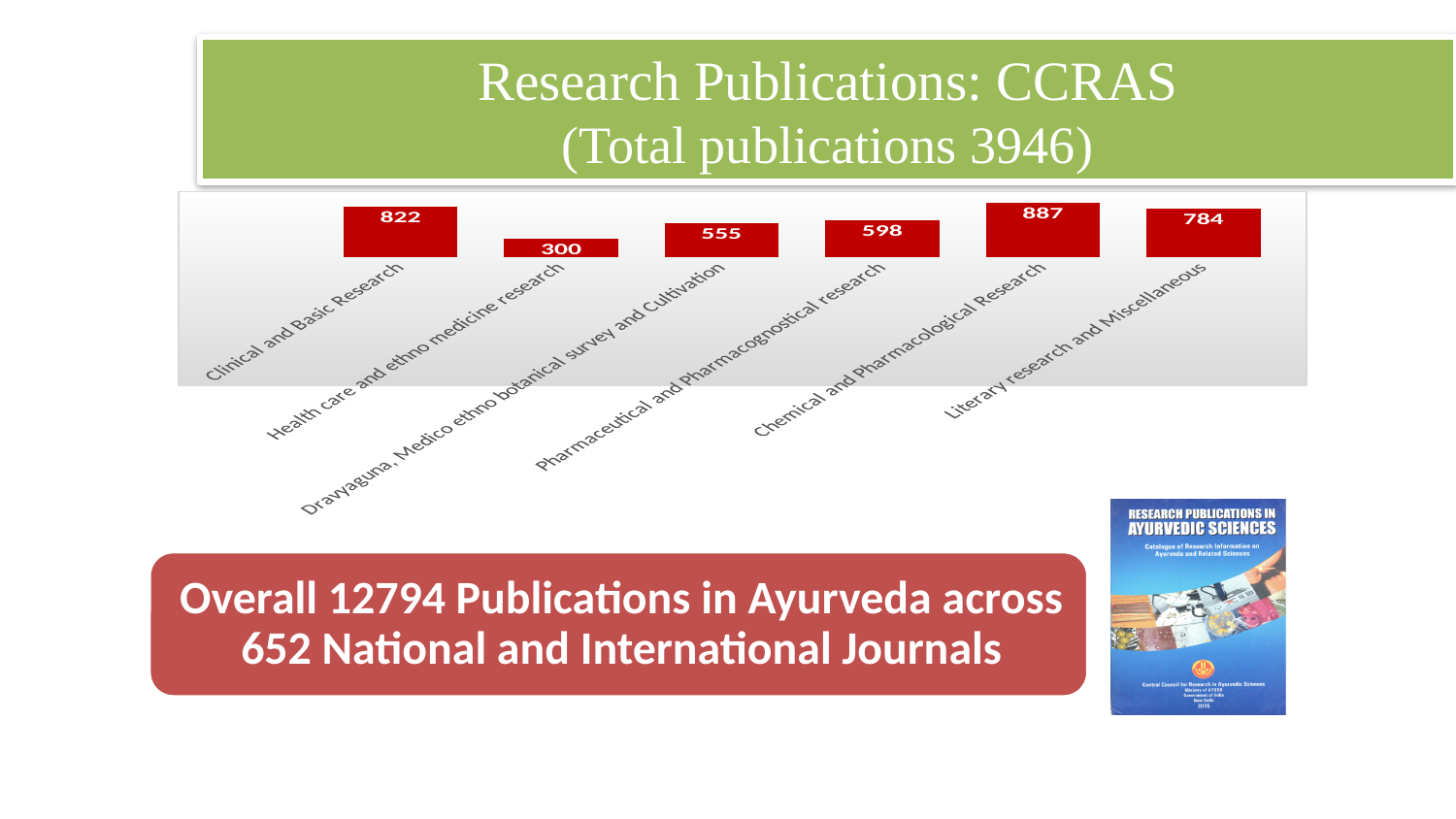
What is the difference between the values for Chemical and Pharmacological Research and Clinical and Basic Research? 65 What is the value for Health care and ethno medicine research? 300 Which category has the highest value? Chemical and Pharmacological Research Which is larger, the value for Literary research and Miscellaneous or the value for Pharmaceutical and Pharmacognostical research? Literary research and Miscellaneous How many categories are shown in the chart? 6 What is the difference between the values for Pharmaceutical and Pharmacognostical research and Dravyaguna, Medico ethno botanical survey and Cultivation? 43 What is the value for Dravyaguna, Medico ethno botanical survey and Cultivation? 555 Which category has the lowest value? Health care and ethno medicine research What kind of chart is shown on the slide? Bar chart What is the value for Pharmaceutical and Pharmacognostical research? 598 What is the value for Clinical and Basic Research? 822 What is the value for Literary research and Miscellaneous? 784